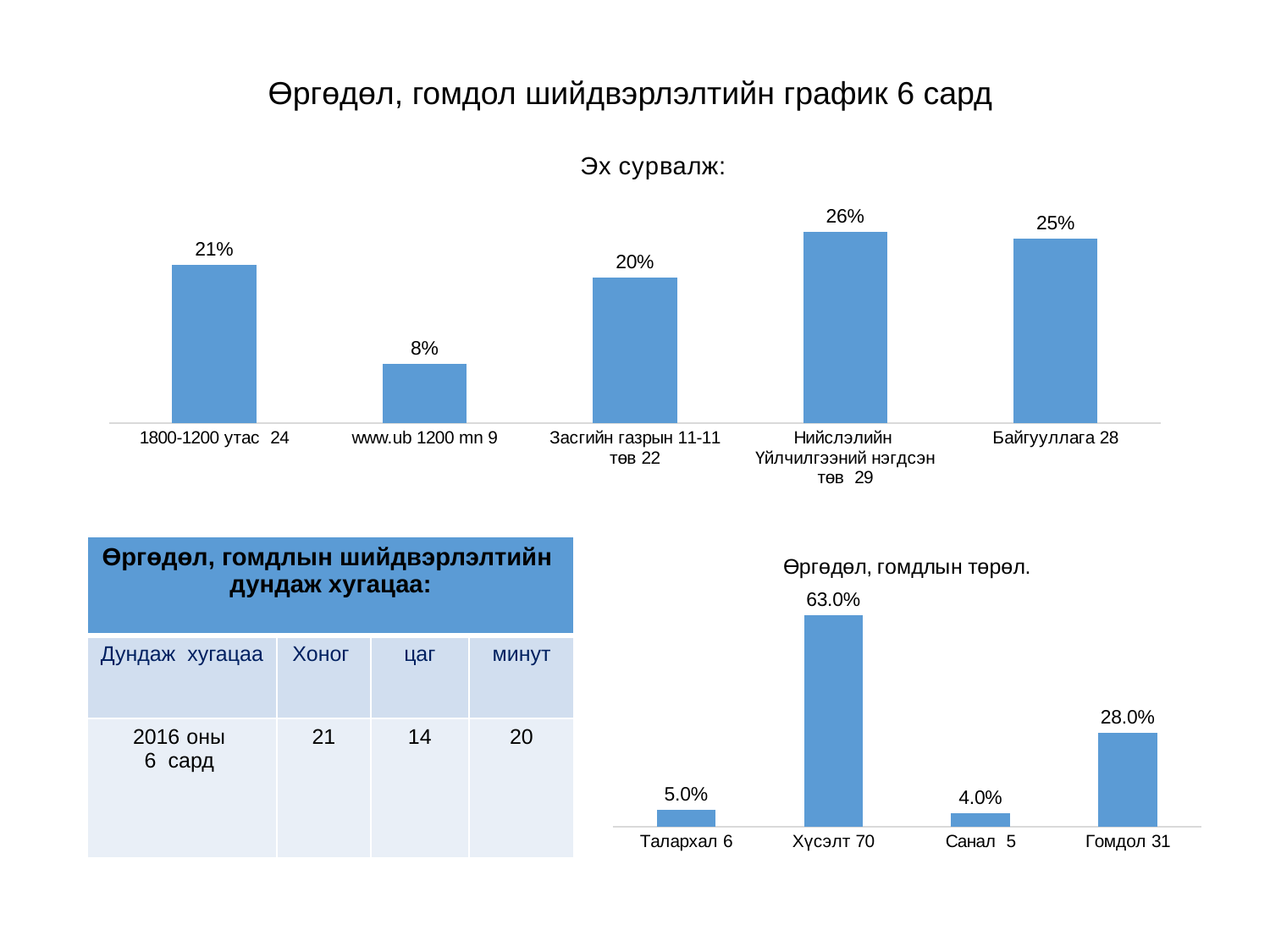
In the "Өргөдөл, гомдлын төрөл." chart, what is the value for "Хүсэлт 70"? 63.0% In the "Эх сурвалж:" chart, how many categories are shown? 5 In the "Эх сурвалж:" chart, which category has the lowest value? www.ub 1200 mn 9 What kind of chart is the "Өргөдөл, гомдлын төрөл." chart? Bar chart In the "Өргөдөл, гомдлын төрөл." chart, which category has the lowest value? Санал 5 In the "Өргөдөл, гомдлын төрөл." chart, what is the difference between the values for "Хүсэлт 70" and "Гомдол 31"? 35.0% In the "Өргөдөл, гомдлын төрөл." chart, which is larger, the value for "Талархал 6" or "Санал 5"? Талархал 6 In the "Эх сурвалж:" chart, which category has the highest value? Нийслэлийн Үйлчилгээний нэгдсэн төв 29 In the "Эх сурвалж:" chart, what is the value for "Байгууллага 28"? 25% In the "Эх сурвалж:" chart, what is the value for "www.ub 1200 mn 9"? 8% In the "Өргөдөл, гомдлын төрөл." chart, what is the value for "Гомдол 31"? 28.0% In the "Эх сурвалж:" chart, what is the difference between the values for "1800-1200 утас 24" and "www.ub 1200 mn 9"? 13%